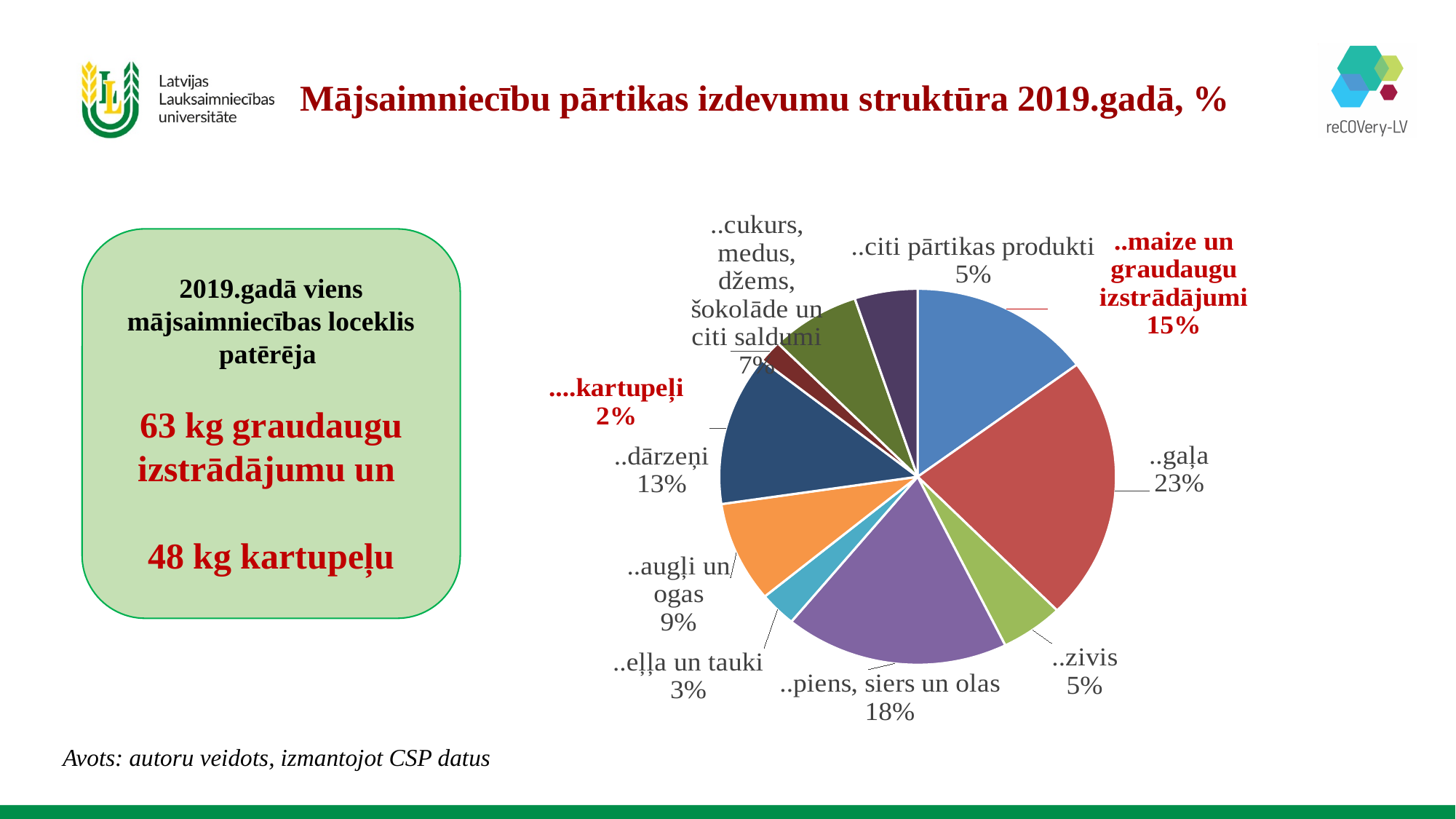
Which category has the largest share of the pie? ..gaļa Which is larger, the share for "..augļi un ogas" or the share for "..cukurs, medus, džems, šokolāde un citi saldumi"? ..augļi un ogas What is the difference in percentage points between "..gaļa" and "..piens, siers un olas"? 5 What percentage is shown for "..maize un graudaugu izstrādājumi"? 15% How many slices does the pie chart have? 10 What percentage is shown for "..dārzeņi"? 13% What percentage is shown for "....kartupeļi"? 2% What percentage is shown for "..piens, siers un olas"? 18% What is the title of the chart on the slide? Mājsaimniecību pārtikas izdevumu struktūra 2019.gadā, % Which category has the smallest share of the pie? ....kartupeļi What type of chart is shown on the slide? pie chart What share of household food expenditure in 2019 goes to "..gaļa"? 23%